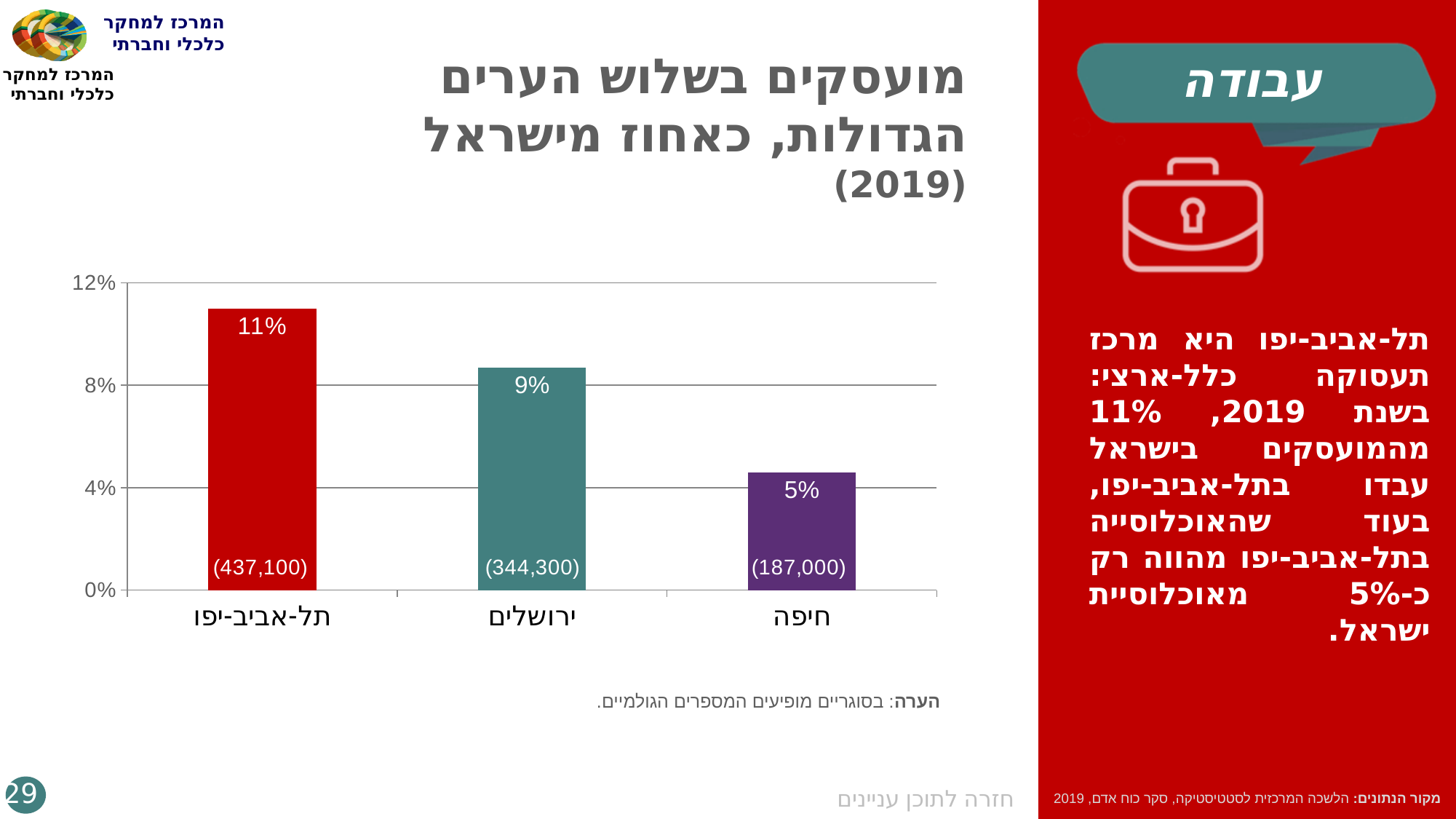
What percentage is shown for תל-אביב-יפו? 11% Which has a larger value, ירושלים or חיפה? ירושלים What absolute number is printed in parentheses on the bar for תל-אביב-יפו? (437,100) What year is given in the chart title? 2019 What percentage is shown for חיפה? 5% What is the difference in percentage points between תל-אביב-יפו and חיפה? 6% How many cities are shown in the chart? 3 Which city has the highest percentage of employed persons? תל-אביב-יפו What percentage is shown for ירושלים? 9% What type of chart is shown on the slide? Bar chart Which city has the lowest percentage of employed persons? חיפה What absolute number is printed in parentheses on the bar for חיפה? (187,000)